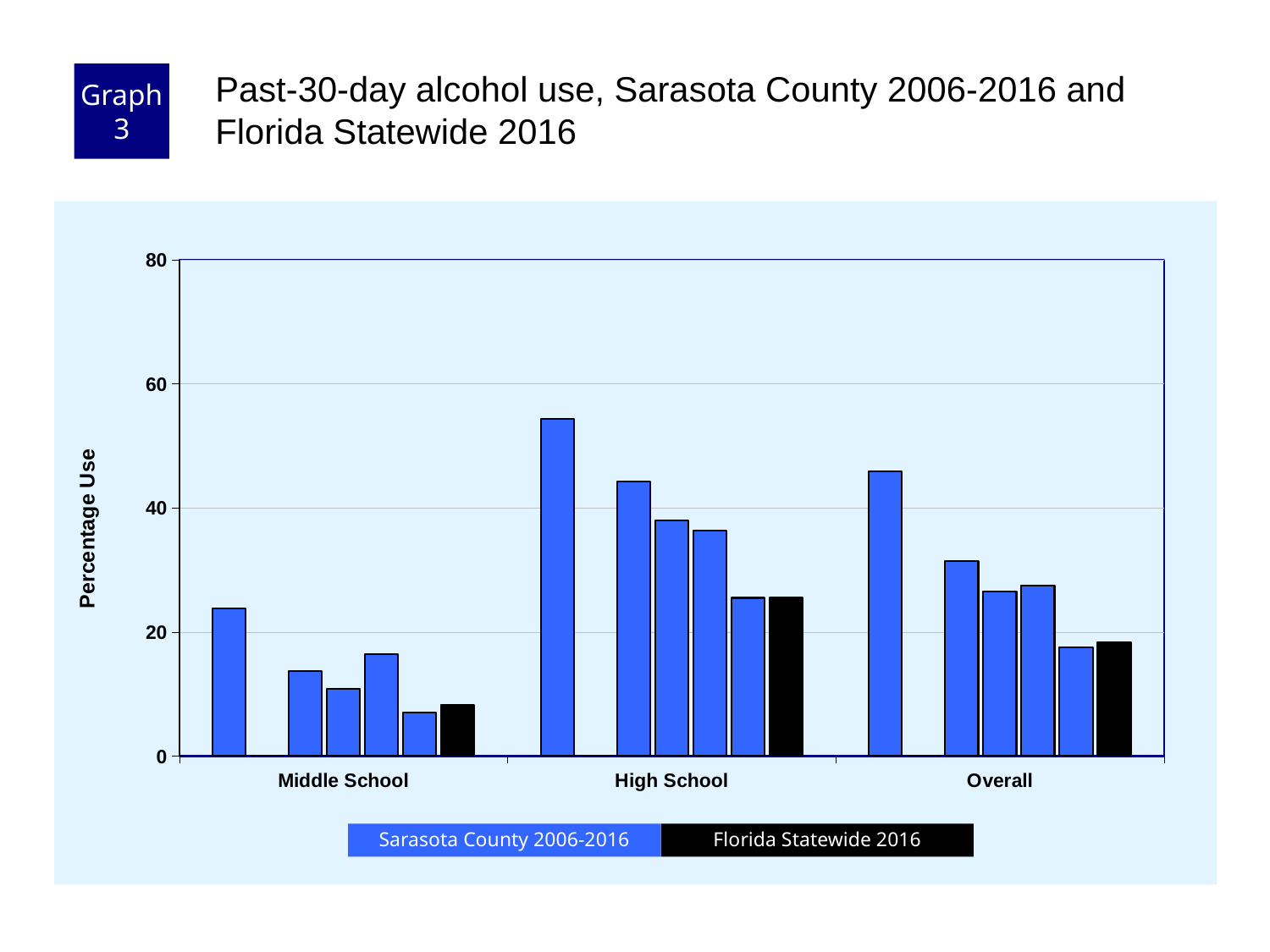
Is the Florida Statewide 2016 value for Middle School greater or less than 20? less Which category has the lowest Florida Statewide 2016 value? Middle School What kind of chart is shown on the slide? bar chart What is the label on the y axis? Percentage Use Is the Florida Statewide 2016 value for Overall greater or less than 40? less How many series does the legend list? 2 Which category has the highest Florida Statewide 2016 value? High School Is the Florida Statewide 2016 value for High School greater or less than 20? greater Which is larger, the Florida Statewide 2016 value for High School or for Middle School? High School How many categories are shown on the x axis? 3 What is the title of the chart? Past-30-day alcohol use, Sarasota County 2006-2016 and Florida Statewide 2016